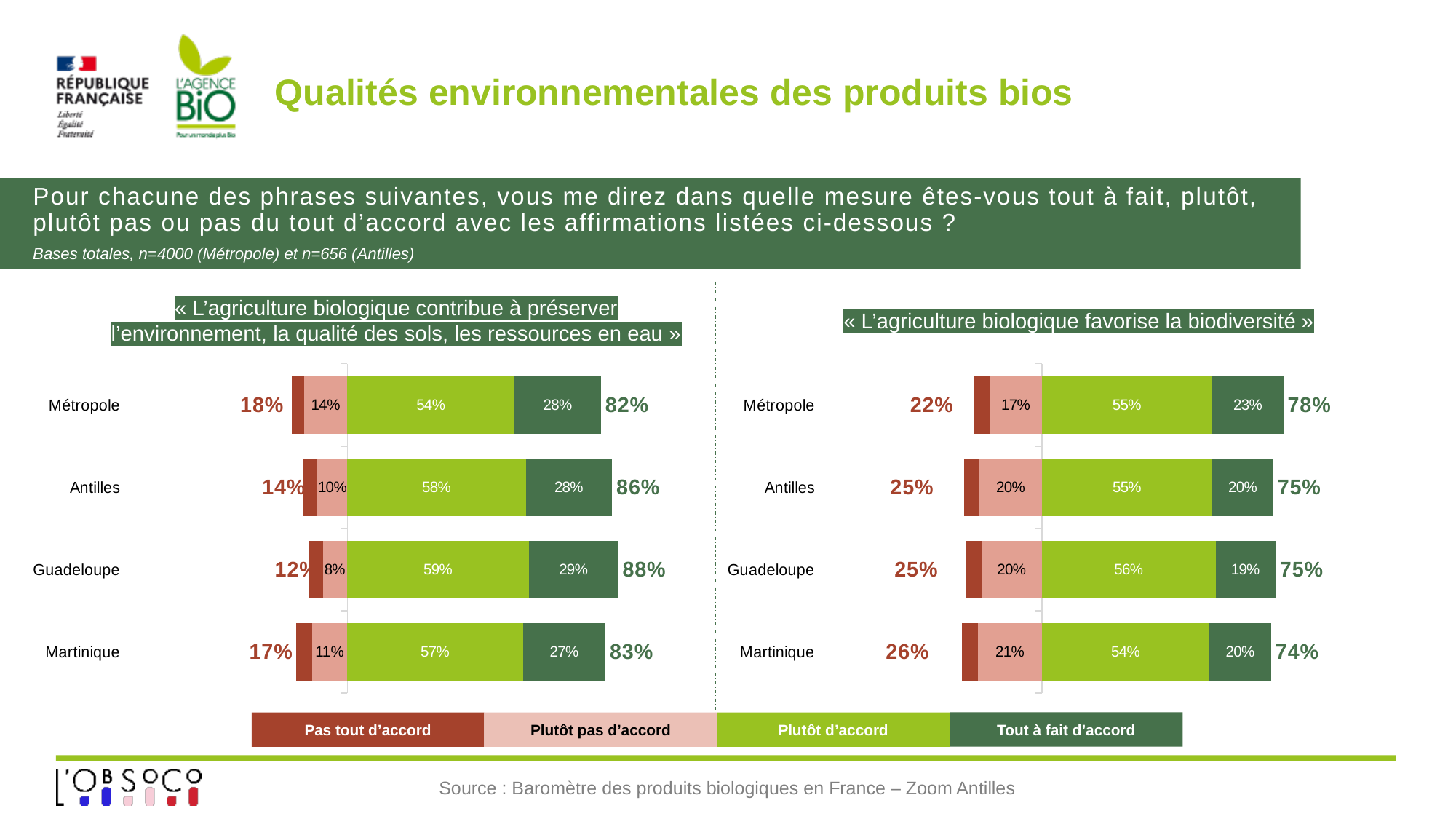
In the right chart, what is the combined total of 'Pas tout d'accord' and 'Plutôt pas d'accord' for Martinique? 26% Which legend entry is shown in dark green? Tout à fait d'accord How many series does the legend list? 4 In the right chart, which region has the lowest 'Plutôt pas d'accord' value? Métropole In the left chart, what is the difference between the 'Plutôt pas d'accord' values for Métropole and Guadeloupe? 6% In the right chart (« L'agriculture biologique favorise la biodiversité »), what is the 'Tout à fait d'accord' value for Métropole? 23% In the left chart (« L'agriculture biologique contribue à préserver l'environnement... »), what is the 'Plutôt d'accord' value for Antilles? 58% In the left chart, which region has the highest 'Plutôt d'accord' value? Guadeloupe In the left chart, what is the combined total of 'Plutôt d'accord' and 'Tout à fait d'accord' for Guadeloupe? 88% What kind of chart is used on this slide? Stacked bar chart How many regions are shown in the left chart? 4 In the right chart, which is larger: the 'Plutôt d'accord' value for Guadeloupe or for Martinique? Guadeloupe